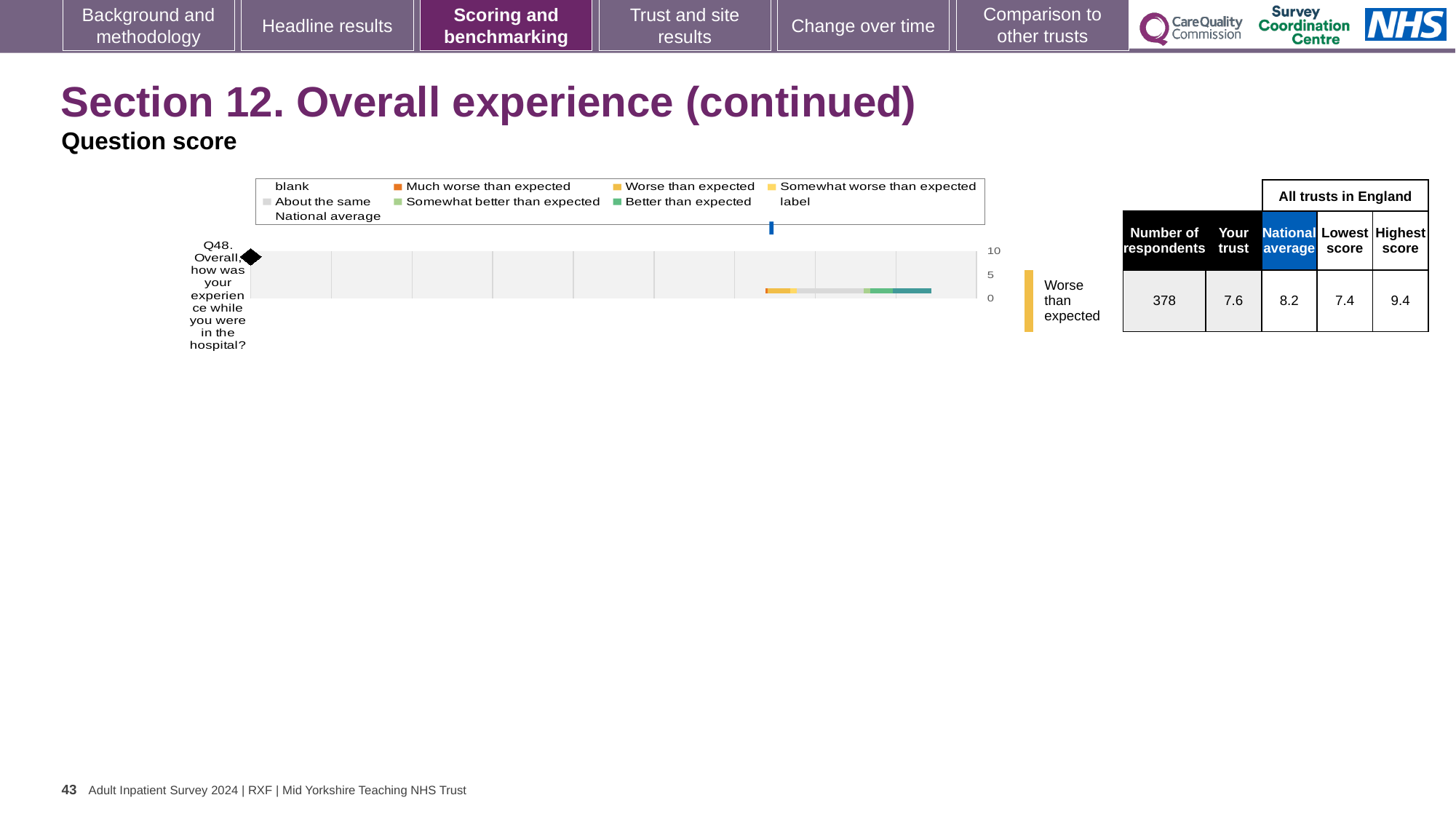
Which survey question is plotted in the chart? Q48. Overall, how was your experience while you were in the hospital? What is the national average score for Q48? 8.2 What is the difference between the highest and lowest scores for Q48 across all trusts in England? 2.0 What is the highest score among all trusts in England for Q48? 9.4 What rating label is shown to the right of the Q48 bar? Worse than expected What kind of chart is used to show the Q48 question score? bar chart What is the lowest score among all trusts in England for Q48? 7.4 What is the 'Your trust' score for Q48? 7.6 Which is larger for Q48, the 'Your trust' score or the national average? National average What is the difference between the national average and the 'Your trust' score for Q48? 0.6 How many survey questions are plotted in the chart? 1 How many respondents answered Q48? 378